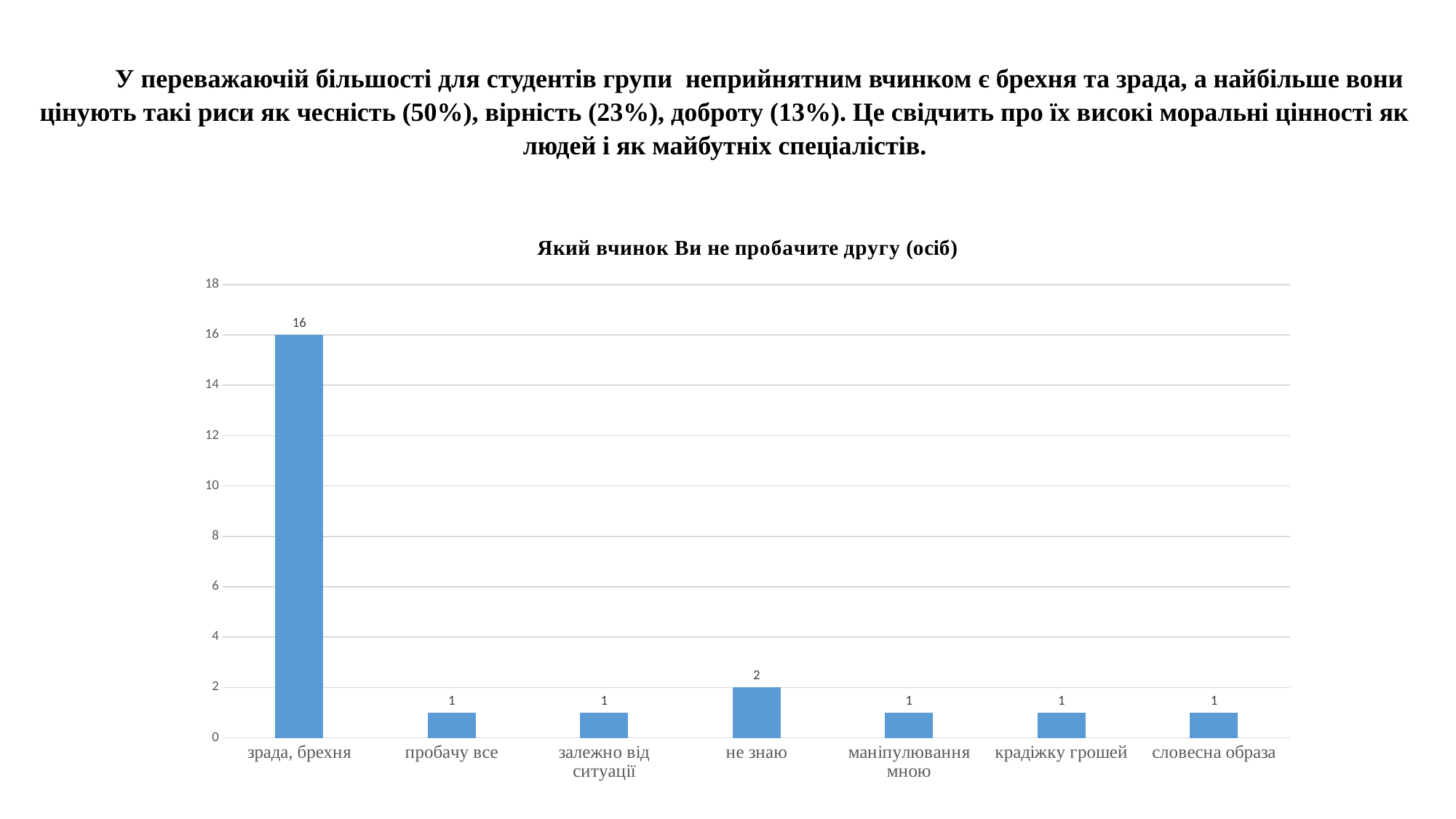
Is the value for "зрада, брехня" greater or less than 10? greater How many categories have a value of 1? 5 What is the value for "зрада, брехня"? 16 What is the title of the chart? Який вчинок Ви не пробачите другу (осіб) How many categories are shown on the x axis? 7 Which is larger, the value for "не знаю" or the value for "пробачу все"? не знаю What is the value for "крадіжку грошей"? 1 Which category has the highest value? зрада, брехня What kind of chart is shown on the slide? bar chart What is the total of all the values shown in the chart? 23 What is the difference between the values for "зрада, брехня" and "не знаю"? 14 What is the value for "не знаю"? 2